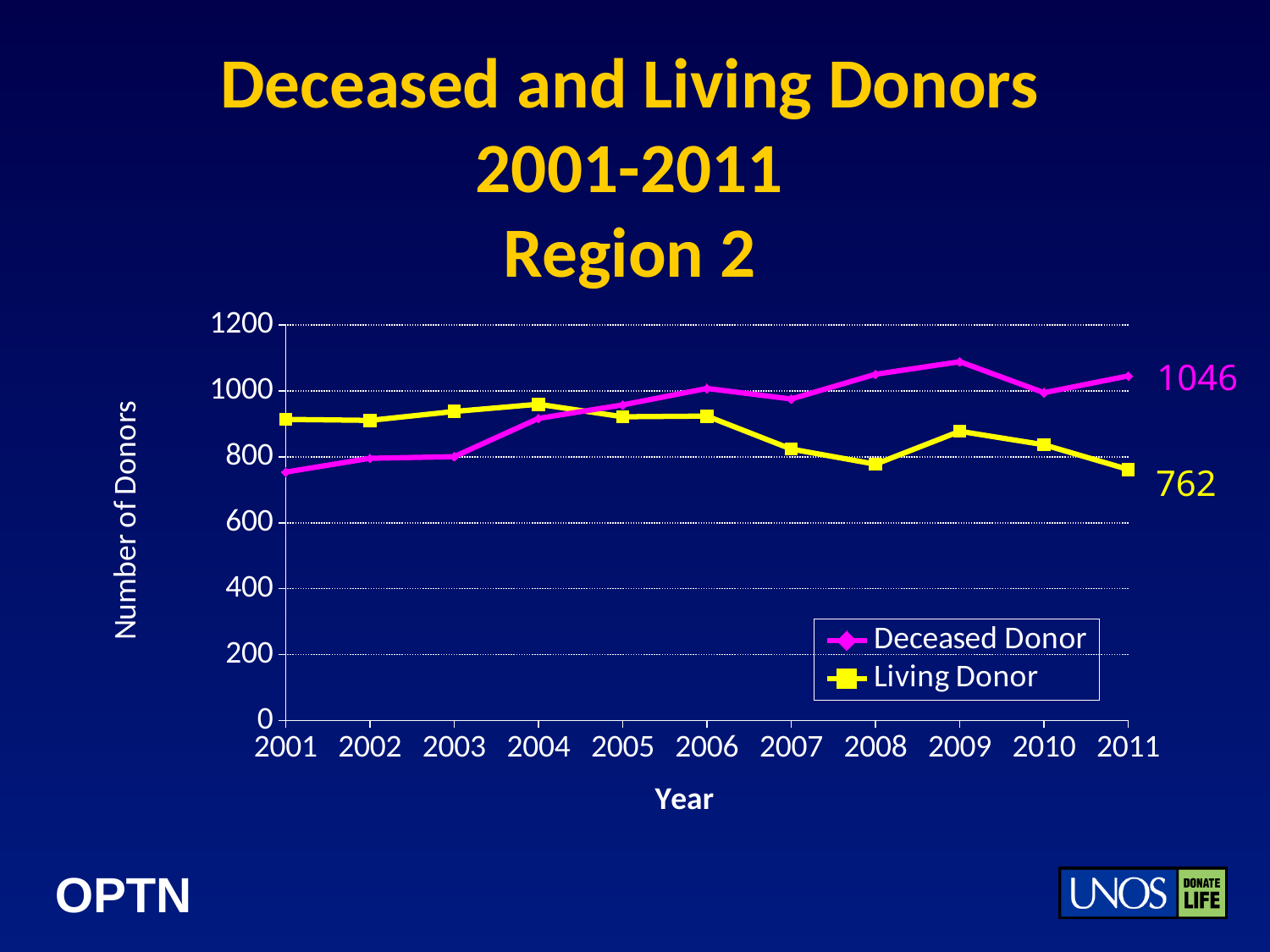
Is the value for Deceased Donor in 2001 greater or less than 800? less What kind of chart is shown on the slide? Line chart What is the difference between the Deceased Donor and Living Donor values in 2011? 284 What is the value for Living Donor in 2011? 762 Is the value for Living Donor in 2004 greater or less than 800? greater In 2011, which series has the larger value, Deceased Donor or Living Donor? Deceased Donor How many years are shown on the x axis? 11 What is the value for Deceased Donor in 2011? 1046 In which year is the Deceased Donor value highest? 2009 In 2001, which series has the larger value, Deceased Donor or Living Donor? Living Donor How many series does the legend list? 2 Is the value for Deceased Donor in 2009 greater or less than 1000? greater